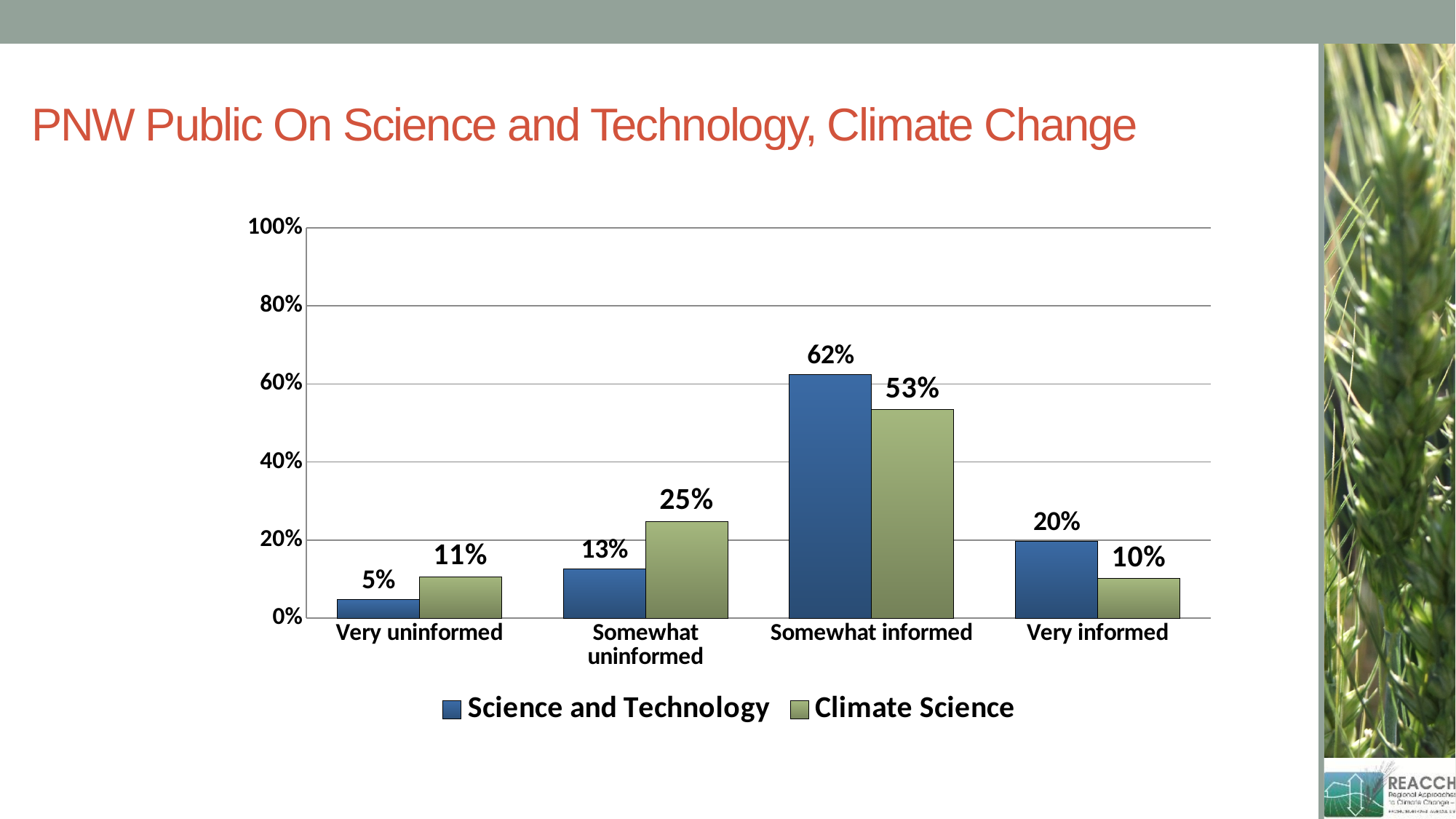
What colour are the Climate Science bars? Green Is the value for Science and Technology in the Somewhat informed category greater or less than 60%? greater What is the value for Climate Science in the Somewhat uninformed category? 25% How many series does the legend list? 2 How many categories are shown on the x axis? 4 What kind of chart is shown on the slide? Bar chart What is the value for Science and Technology in the Somewhat informed category? 62% Which category has the lowest value for Science and Technology? Very uninformed Which category has the highest value for Climate Science? Somewhat informed Which series has the larger value in the Very uninformed category, Science and Technology or Climate Science? Climate Science What is the value for Climate Science in the Very informed category? 10% What is the difference between the Science and Technology and Climate Science values in the Somewhat informed category? 9%